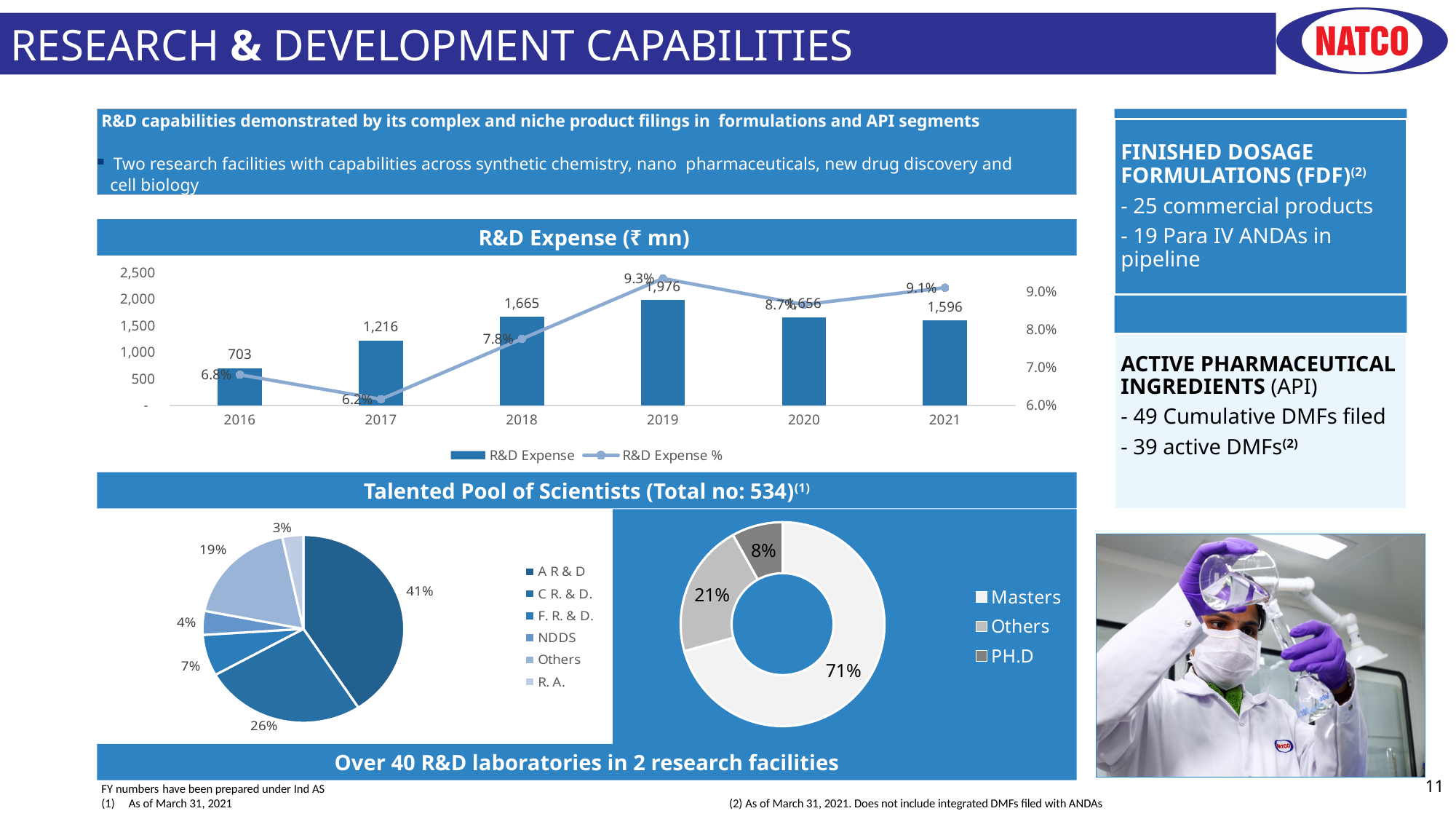
In the R&D Expense (₹ mn) chart, what is the R&D Expense % for 2018? 7.8% In the R&D Expense (₹ mn) chart, what is the difference between the R&D Expense in 2019 and in 2021? 380 In the pie chart under 'Talented Pool of Scientists', which category has the smallest share? R. A. In the R&D Expense (₹ mn) chart, what is the R&D Expense for 2019? 1,976 In the R&D Expense (₹ mn) chart, how many series does the legend list? 2 In the R&D Expense (₹ mn) chart, which year has the highest R&D Expense? 2019 In the donut chart under 'Talented Pool of Scientists', what share is Masters? 71% In the R&D Expense (₹ mn) chart, how many years are shown on the x axis? 6 What kind of chart is the left chart under 'Talented Pool of Scientists'? Pie chart In the R&D Expense (₹ mn) chart, which year has the lowest R&D Expense? 2016 In the pie chart under 'Talented Pool of Scientists', what share is A R & D? 41% In the R&D Expense (₹ mn) chart, which year has the larger R&D Expense, 2017 or 2021? 2021